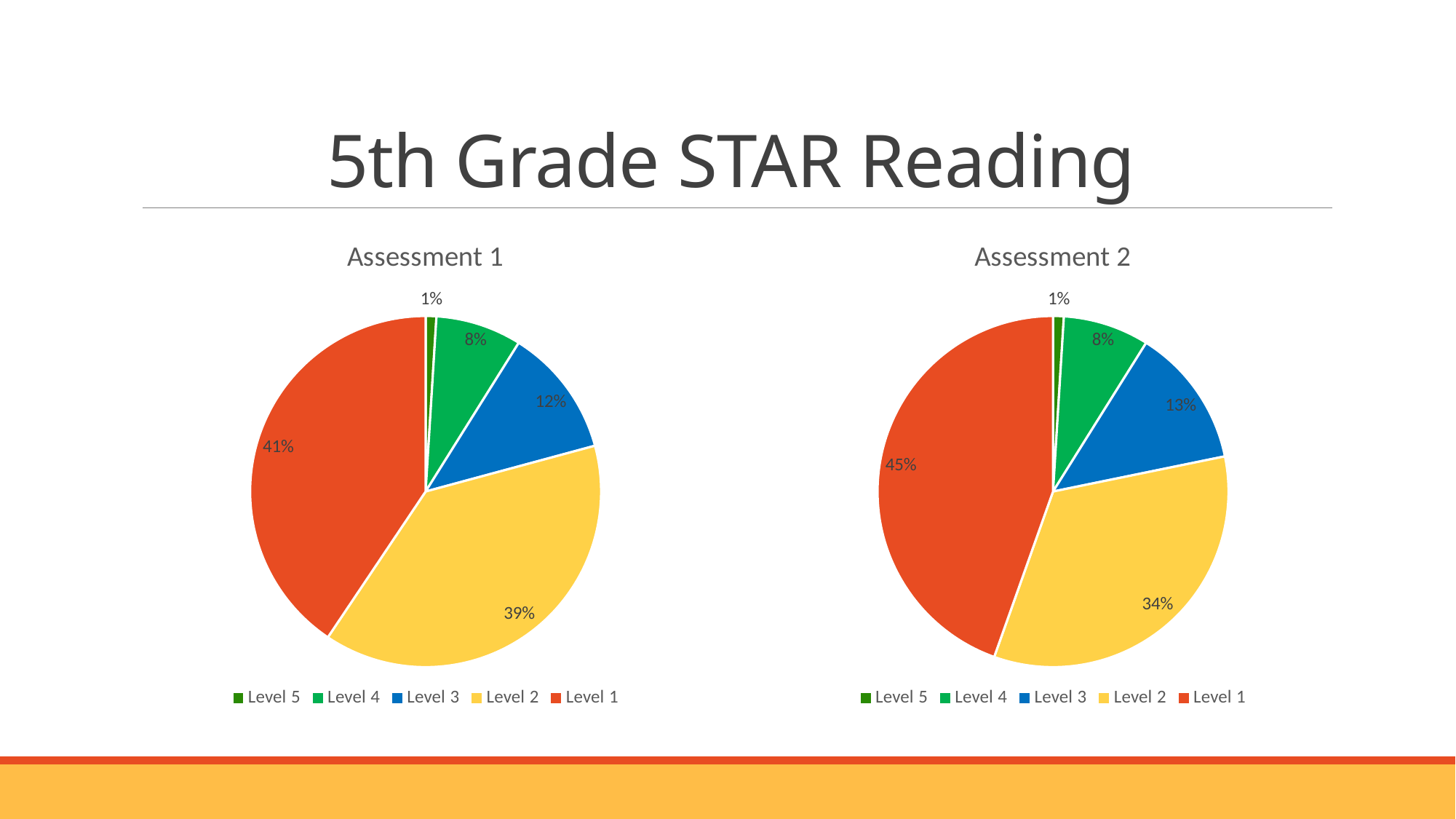
What colour represents Level 3 in the Assessment 2 chart? Blue How many entries does the legend of the Assessment 1 chart list? 5 In the Assessment 1 chart, what share of students are at Level 1? 41% In the Assessment 2 chart, what share of students are at Level 2? 34% What kind of chart is used for Assessment 2? Pie chart In the Assessment 1 chart, what share of students are at Level 4? 8% How many slices does the Assessment 1 pie chart have? 5 In the Assessment 2 chart, what share of students are at Level 3? 13% In the Assessment 2 chart, what is the difference between the Level 1 and Level 2 shares? 11% In the Assessment 1 chart, which level has the largest slice? Level 1 In the Assessment 1 chart, which is larger, the Level 2 slice or the Level 3 slice? Level 2 In the Assessment 2 chart, which level has the smallest slice? Level 5